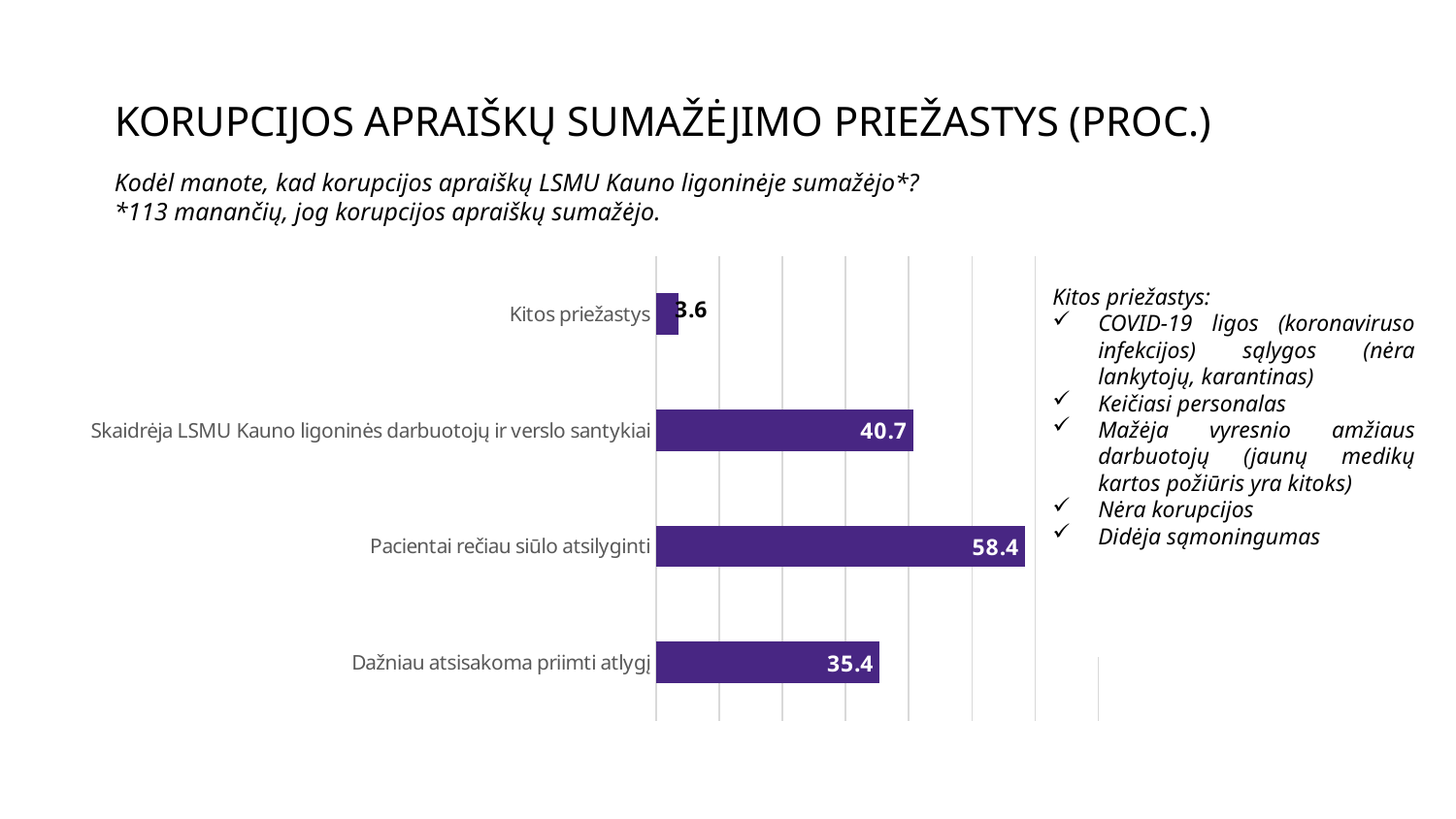
Which is larger: the value for "Dažniau atsisakoma priimti atlygį" or the value for "Skaidrėja LSMU Kauno ligoninės darbuotojų ir verslo santykiai"? Skaidrėja LSMU Kauno ligoninės darbuotojų ir verslo santykiai Which category has the lowest value? Kitos priežastys What is the value for "Skaidrėja LSMU Kauno ligoninės darbuotojų ir verslo santykiai"? 40.7 How many categories are shown in the chart? 4 What kind of chart is shown on the slide? Bar chart What is the difference between the values for "Skaidrėja LSMU Kauno ligoninės darbuotojų ir verslo santykiai" and "Dažniau atsisakoma priimti atlygį"? 5.3 What is the value for "Dažniau atsisakoma priimti atlygį"? 35.4 What is the difference between the values for "Pacientai rečiau siūlo atsilyginti" and "Skaidrėja LSMU Kauno ligoninės darbuotojų ir verslo santykiai"? 17.7 Which category has the highest value? Pacientai rečiau siūlo atsilyginti What is the value for "Pacientai rečiau siūlo atsilyginti"? 58.4 What is the value for "Kitos priežastys"? 3.6 What is the title of the slide containing the chart? KORUPCIJOS APRAIŠKŲ SUMAŽĖJIMO PRIEŽASTYS (PROC.)